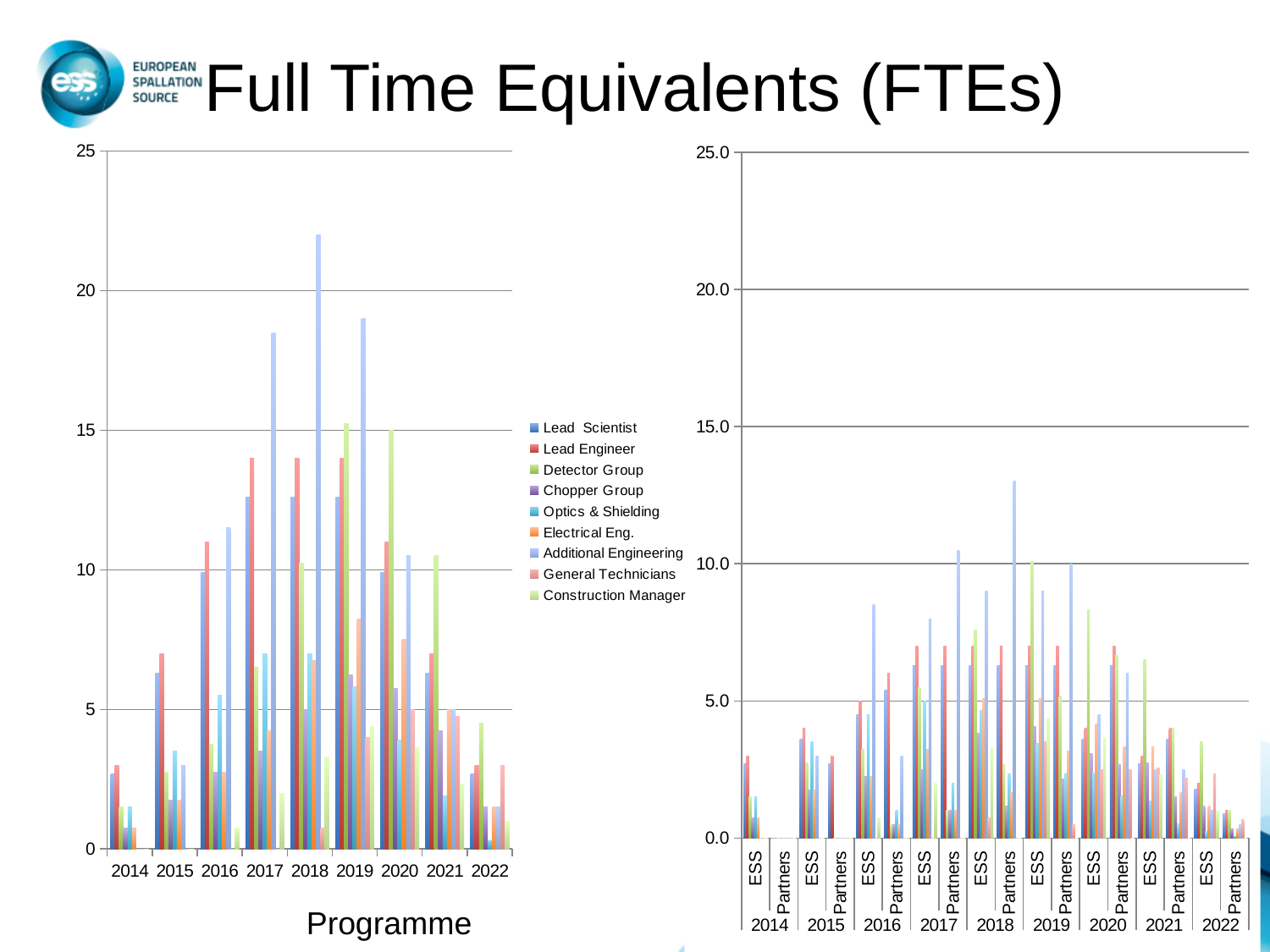
What kind of chart is the left chart labelled "Programme"? bar chart In the left chart labelled "Programme", which is larger: Additional Engineering in 2018 or Additional Engineering in 2022? Additional Engineering in 2018 In the left chart labelled "Programme", is the value for Lead Scientist in 2014 greater or less than 5? less In the right chart, which year and group contains the tallest bar? 2018 Partners How many years are shown on the x axis of the left chart labelled "Programme"? 9 In the left chart labelled "Programme", which year contains the tallest bar? 2018 How many ESS/Partners category groups are shown on the x axis of the right chart? 18 In the left chart labelled "Programme", is the value for Lead Engineer in 2017 greater or less than 10? greater What is the highest tick value on the y axis of the right chart? 25.0 In the left chart labelled "Programme", is the value for Additional Engineering in 2018 greater or less than 20? greater How many series does the legend between the two charts list? 9